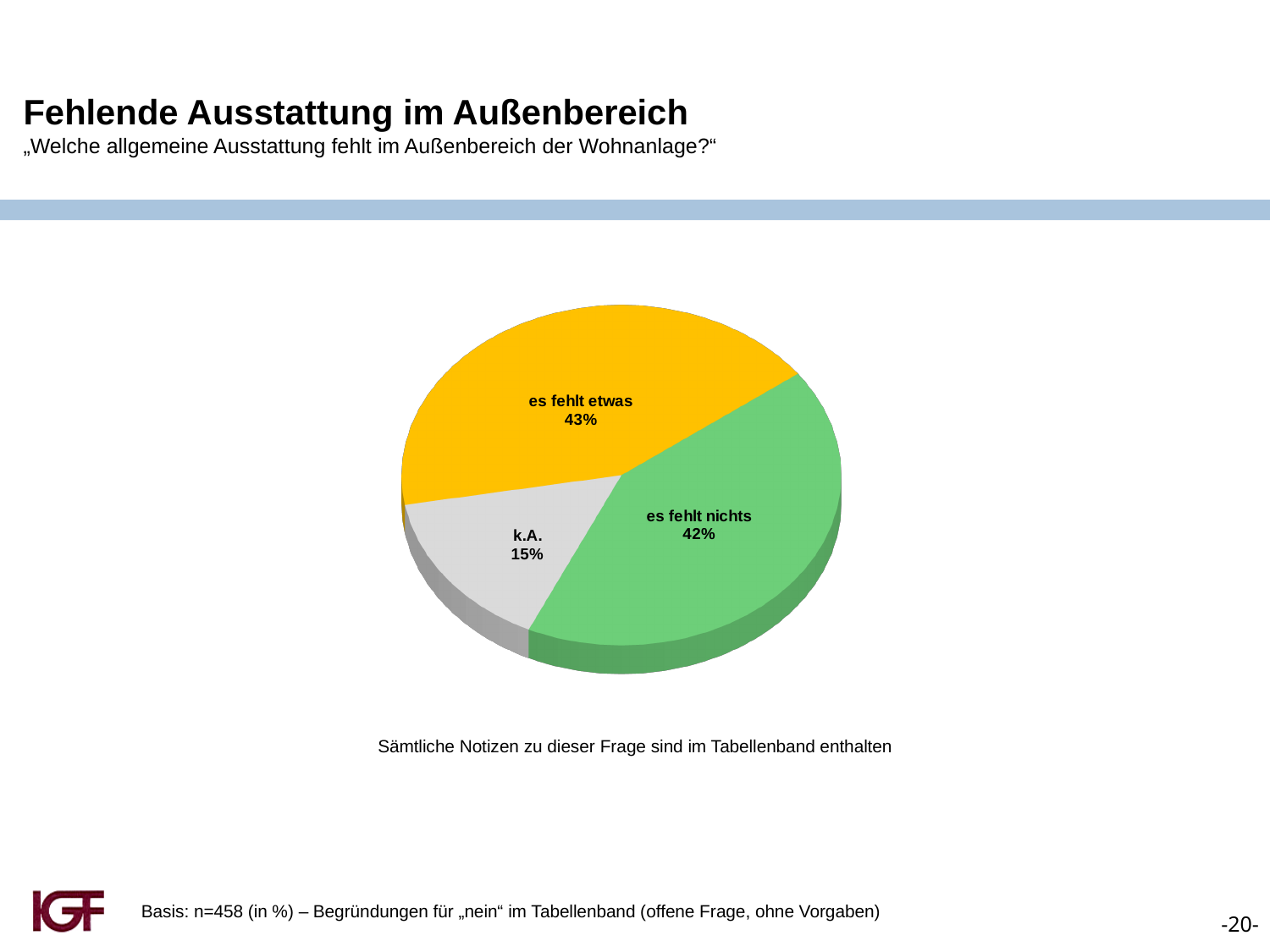
Which is larger: the share for "es fehlt nichts" or the share for "k.A."? es fehlt nichts What share of the pie is labelled "k.A."? 15% What share of the pie is labelled "es fehlt etwas"? 43% What is the combined share of "es fehlt etwas" and "es fehlt nichts"? 85% What colour is the "es fehlt etwas" slice? yellow What share of the pie is labelled "es fehlt nichts"? 42% What is the difference in percentage points between "es fehlt nichts" and "k.A."? 27 What colour is the "es fehlt nichts" slice? green How many slices does the pie chart have? 3 Which slice of the pie is the smallest? k.A. What type of chart is shown on the slide? pie chart What is the difference in percentage points between "es fehlt etwas" and "k.A."? 28